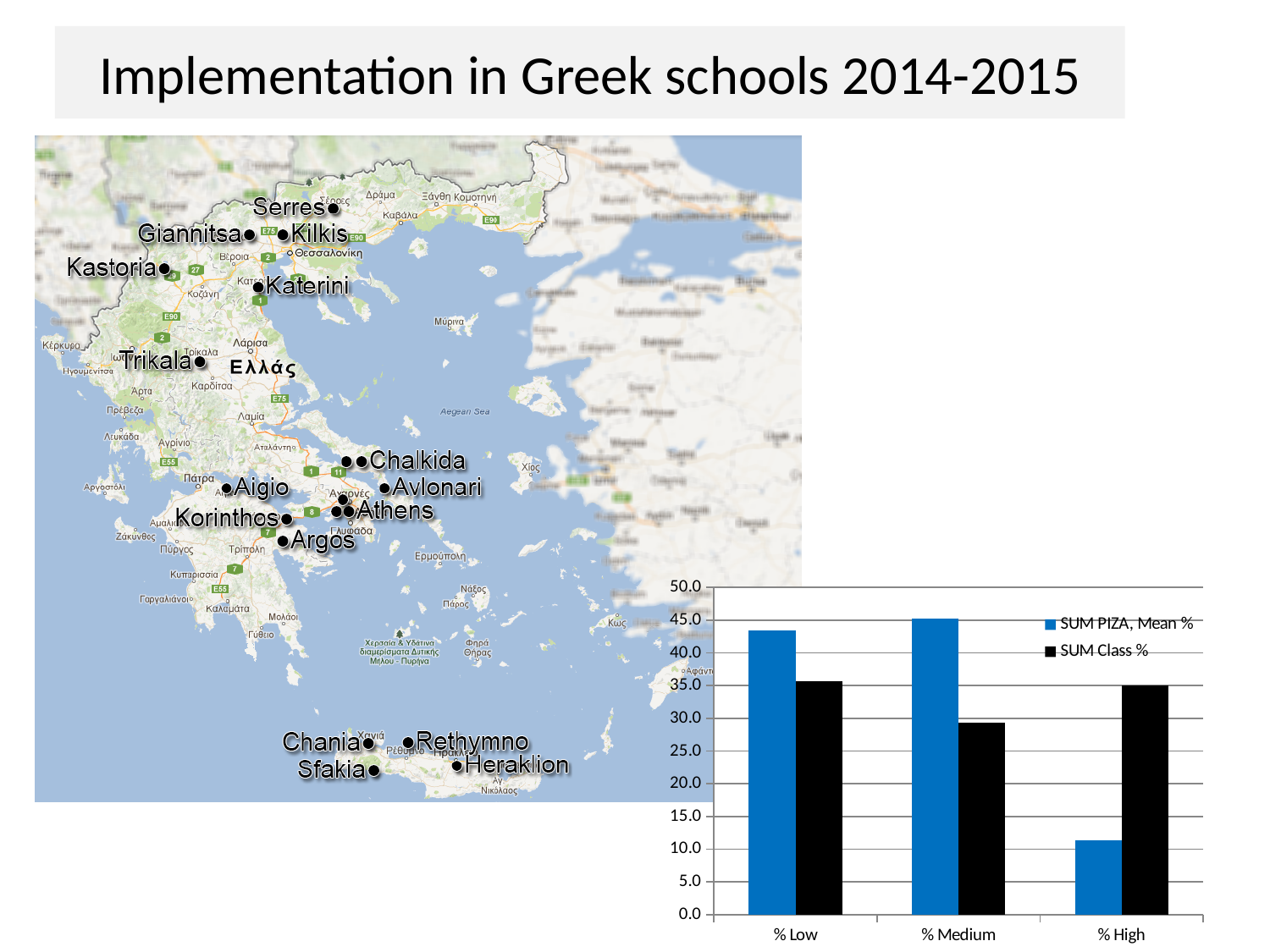
What kind of chart is shown on the slide? bar chart How many categories are shown on the x axis of the chart? 3 For % High, which series has the larger value, SUM PIZA, Mean % or SUM Class %? SUM Class % Which category has the lowest SUM PIZA, Mean % value? % High How many series does the chart's legend list? 2 Which series is shown in blue in the chart? SUM PIZA, Mean % Is the SUM PIZA, Mean % value for % High greater or less than 15? less Which series is shown in black in the chart? SUM Class % Is the SUM Class % value for % High greater or less than 30? greater Is the SUM Class % value for % Medium greater or less than 35? less For % Low, which series has the larger value, SUM PIZA, Mean % or SUM Class %? SUM PIZA, Mean %